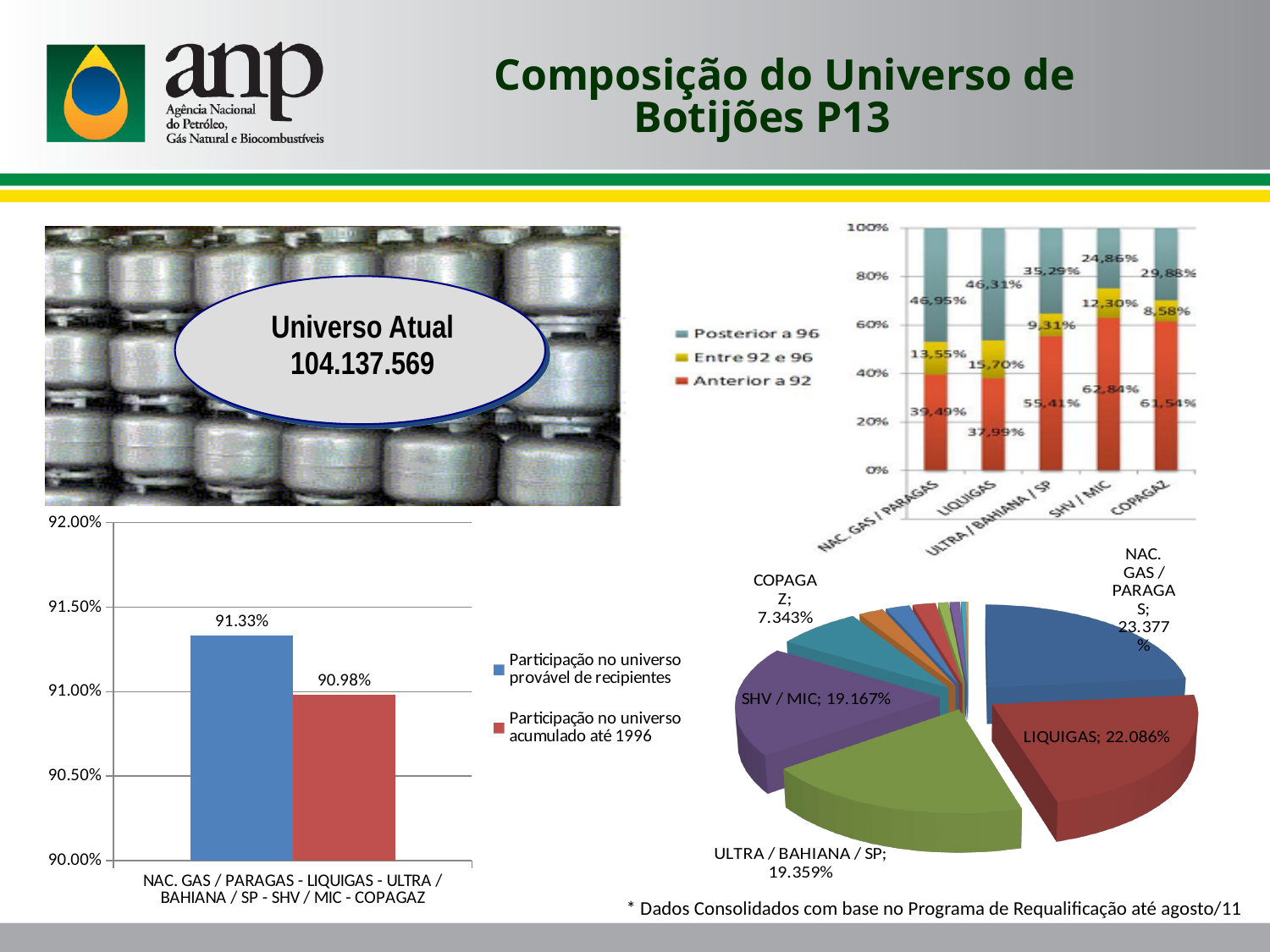
In the stacked bar chart at the top right, which category has the highest 'Anterior a 92' value? SHV / MIC What kind of chart is shown at the bottom right of the slide? Pie chart In the bar chart at the bottom left, what is the value of 'Participação no universo acumulado até 1996'? 90.98% In the stacked bar chart at the top right, how many categories are shown on the x axis? 5 In the bar chart at the bottom left, what is the value of 'Participação no universo provável de recipientes'? 91.33% In the pie chart at the bottom right, which is larger, SHV / MIC or COPAGAZ? SHV / MIC In the stacked bar chart at the top right, what is the value of 'Posterior a 96' for NAC. GAS / PARAGAS? 46,95% In the bar chart at the bottom left, what is the difference between the two bars? 0.35% In the stacked bar chart at the top right, what is the value of 'Entre 92 e 96' for COPAGAZ? 8,58% In the stacked bar chart at the top right, what is the value of 'Anterior a 92' for SHV / MIC? 62,84% In the stacked bar chart at the top right, how many series does the legend list? 3 In the pie chart at the bottom right, what share does LIQUIGAS have? 22.086%